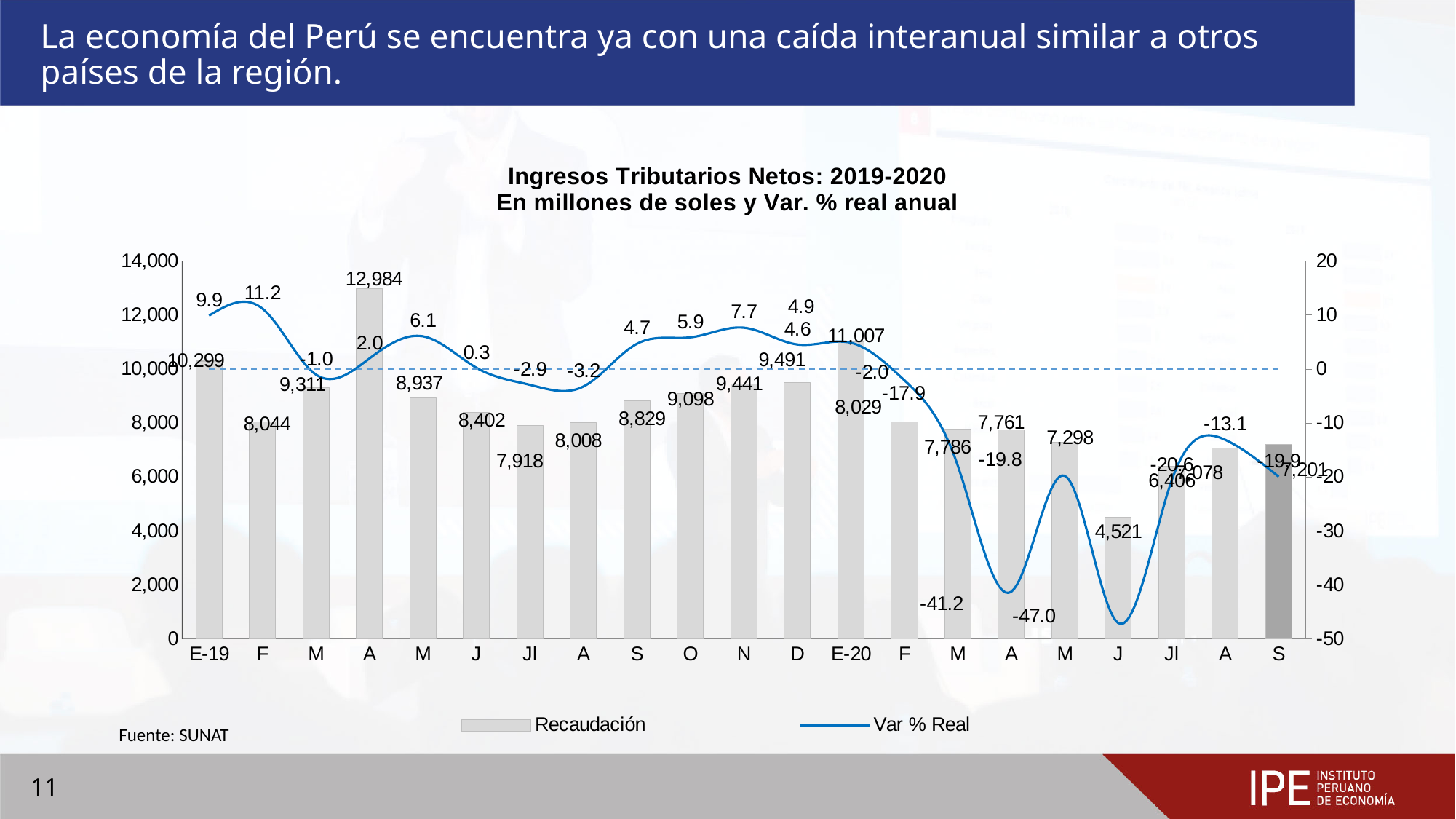
What are the two legend entries of the chart? Recaudación and Var % Real What is the Recaudación value for S (September) 2020? 7,201 What is the difference in Recaudación between E-20 (11,007) and E-19 (10,299)? 708 How many series does the legend list? 2 What is the Var % Real value for J (June) 2020? -47.0 What is the Recaudación value for E-20 (January 2020)? 11,007 What kind of chart is shown on the slide? A combined bar and line chart Which month has the highest Var % Real value? F (February) 2019, 11.2 Which month has the highest Recaudación bar? A (April) 2019, 12,984 How many months (categories) are plotted along the x axis? 21 Which month has the lowest Recaudación bar? J (June) 2020, 4,521 Which is larger, the Recaudación for E-19 or for E-20? E-20